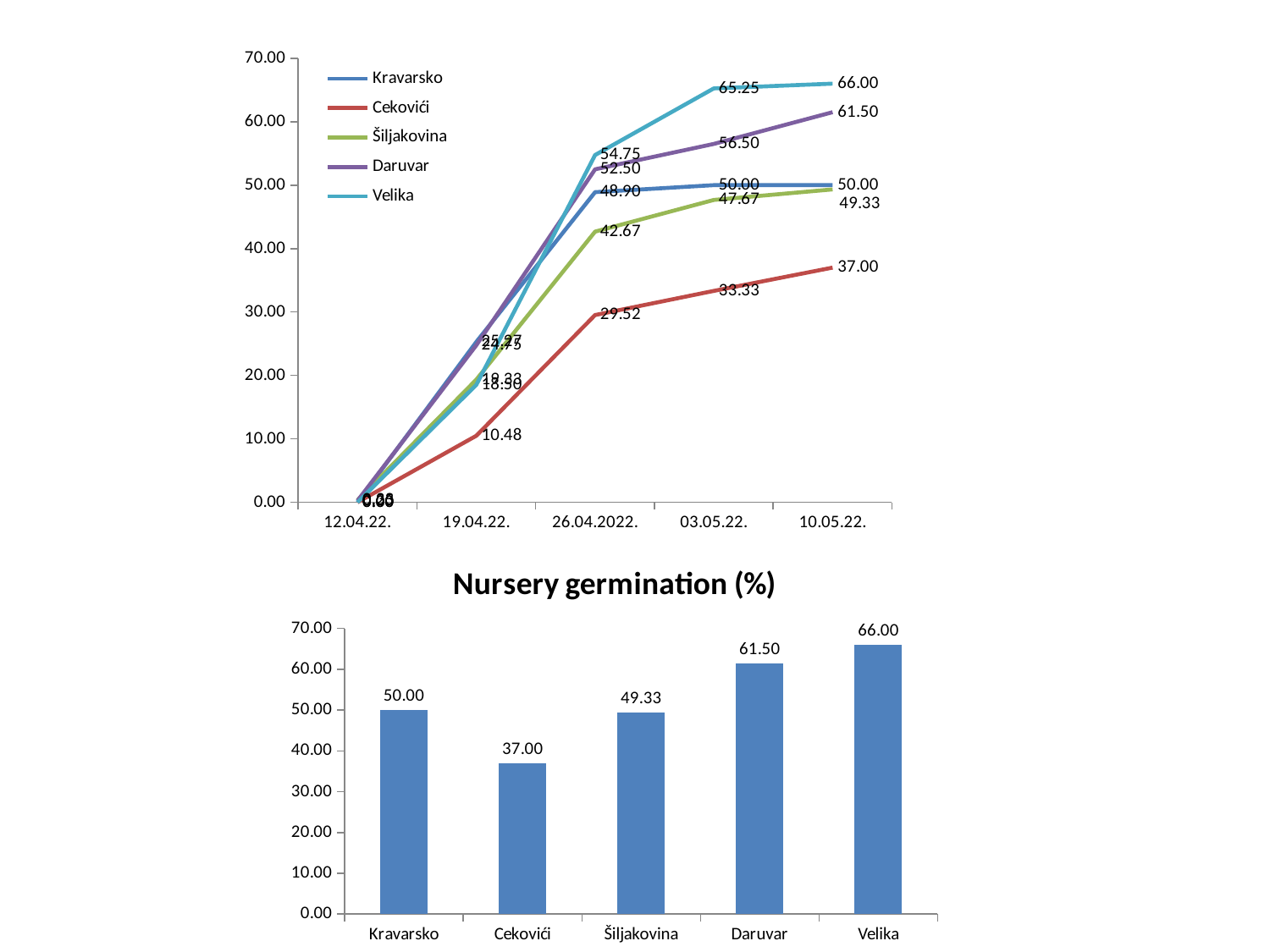
In the top line chart, do the values for Cekovići rise or fall from 12.04.22. to 10.05.22.? rise In the top line chart, how many series does the legend list? 5 In the bottom chart titled 'Nursery germination (%)', what is the difference between the values for Velika and Cekovići? 29.00 In the bottom chart titled 'Nursery germination (%)', which category has the highest value? Velika What kind of chart is the bottom chart titled 'Nursery germination (%)'? bar chart In the top line chart, what is the value for Velika on 03.05.22.? 65.25 In the bottom chart titled 'Nursery germination (%)', which category has the lowest value? Cekovići In the top line chart, which is larger on 10.05.22., Daruvar or Kravarsko? Daruvar In the top line chart, what is the value for Cekovići on 26.04.2022.? 29.52 In the top line chart, what is the difference between the values for Šiljakovina on 03.05.22. and 26.04.2022.? 5.00 In the bottom chart titled 'Nursery germination (%)', how many categories are shown? 5 In the bottom chart titled 'Nursery germination (%)', what is the value for Daruvar? 61.50